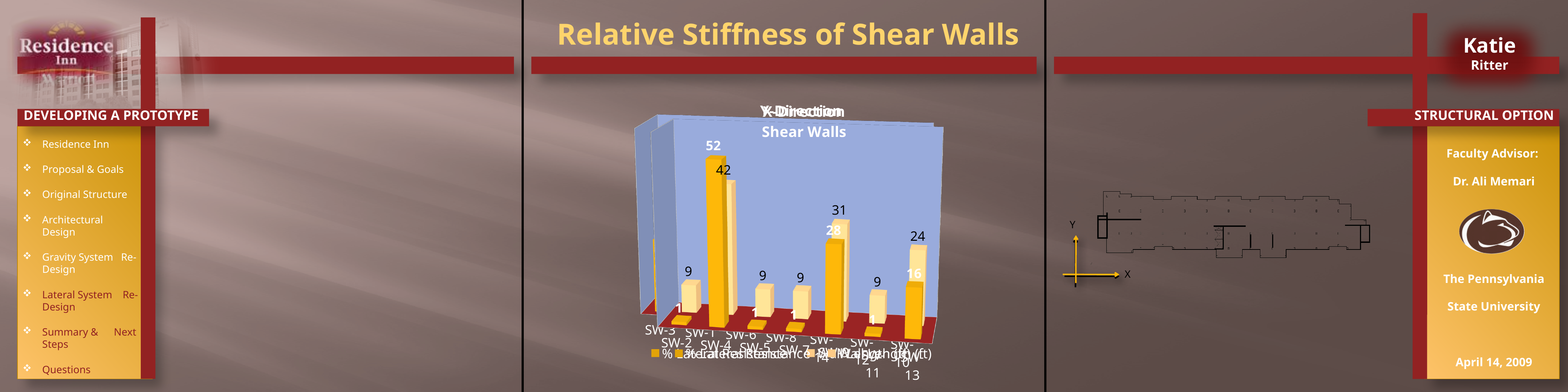
Which is larger, the bar labelled 52 or the bar labelled 42? 52 What kind of chart is shown on the slide? bar chart What is the title of the slide? Relative Stiffness of Shear Walls What colour is the tallest bar on the chart? orange What is the difference between the bar labelled 31 and the bar labelled 28? 3 What is the largest value printed as a data label on the chart? 52 What is the smallest value printed as a data label on the chart? 1 What is the difference between the bar labelled 24 and the bar labelled 16? 8